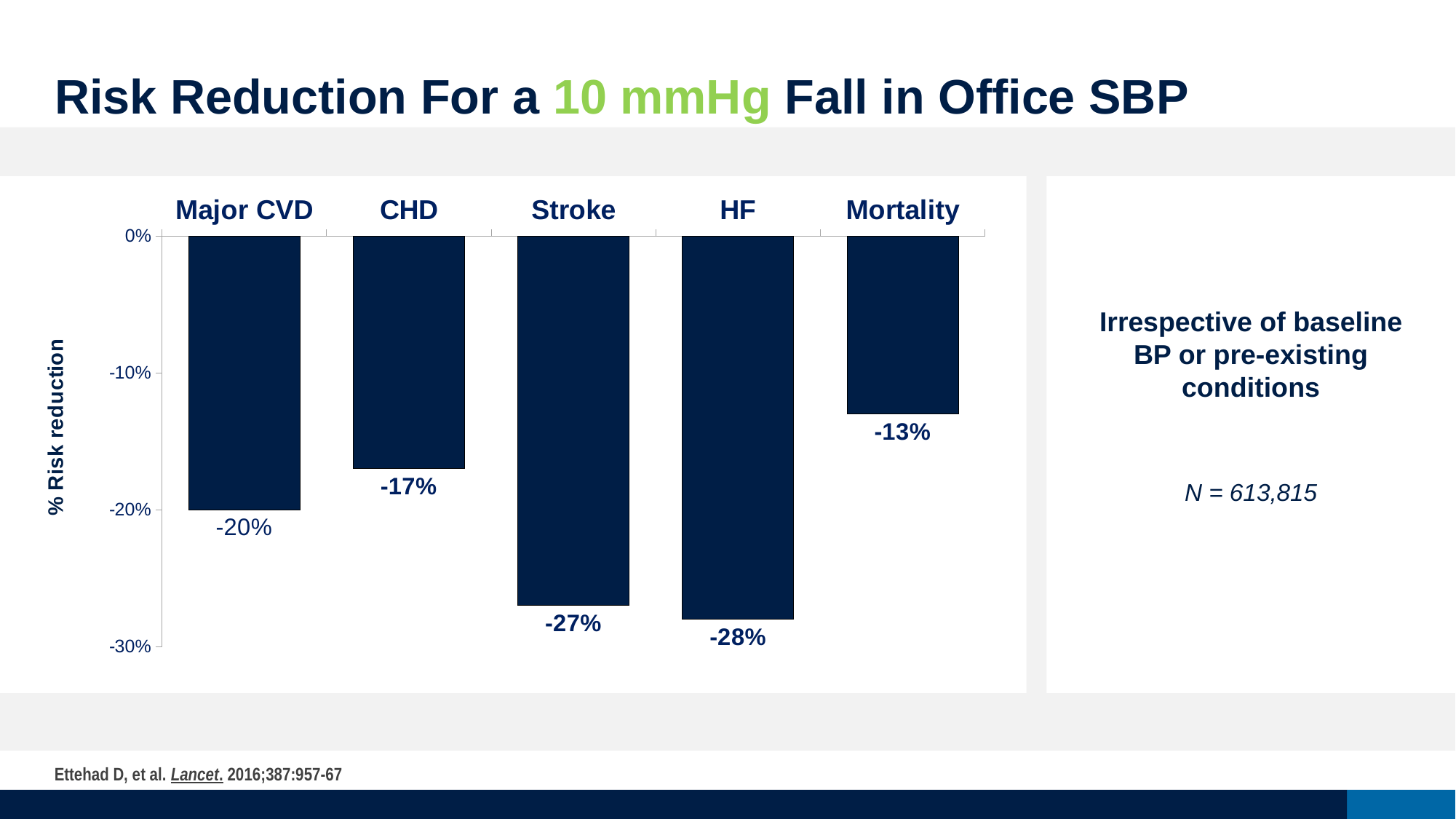
What is the % risk reduction for CHD? -17% What is the title of the slide's chart? Risk Reduction For a 10 mmHg Fall in Office SBP What is the % risk reduction for Stroke? -27% Which category shows the smallest risk reduction? Mortality What is the % risk reduction for Mortality? -13% What kind of chart is shown on the slide? Bar chart What is the difference in percentage points between the risk reduction for HF and for Mortality? 15 percentage points Which category shows the largest risk reduction? HF How many categories are shown in the chart? 5 Which has a larger risk reduction, Major CVD or CHD? Major CVD What is the label of the vertical axis? % Risk reduction What is the % risk reduction for Major CVD? -20%